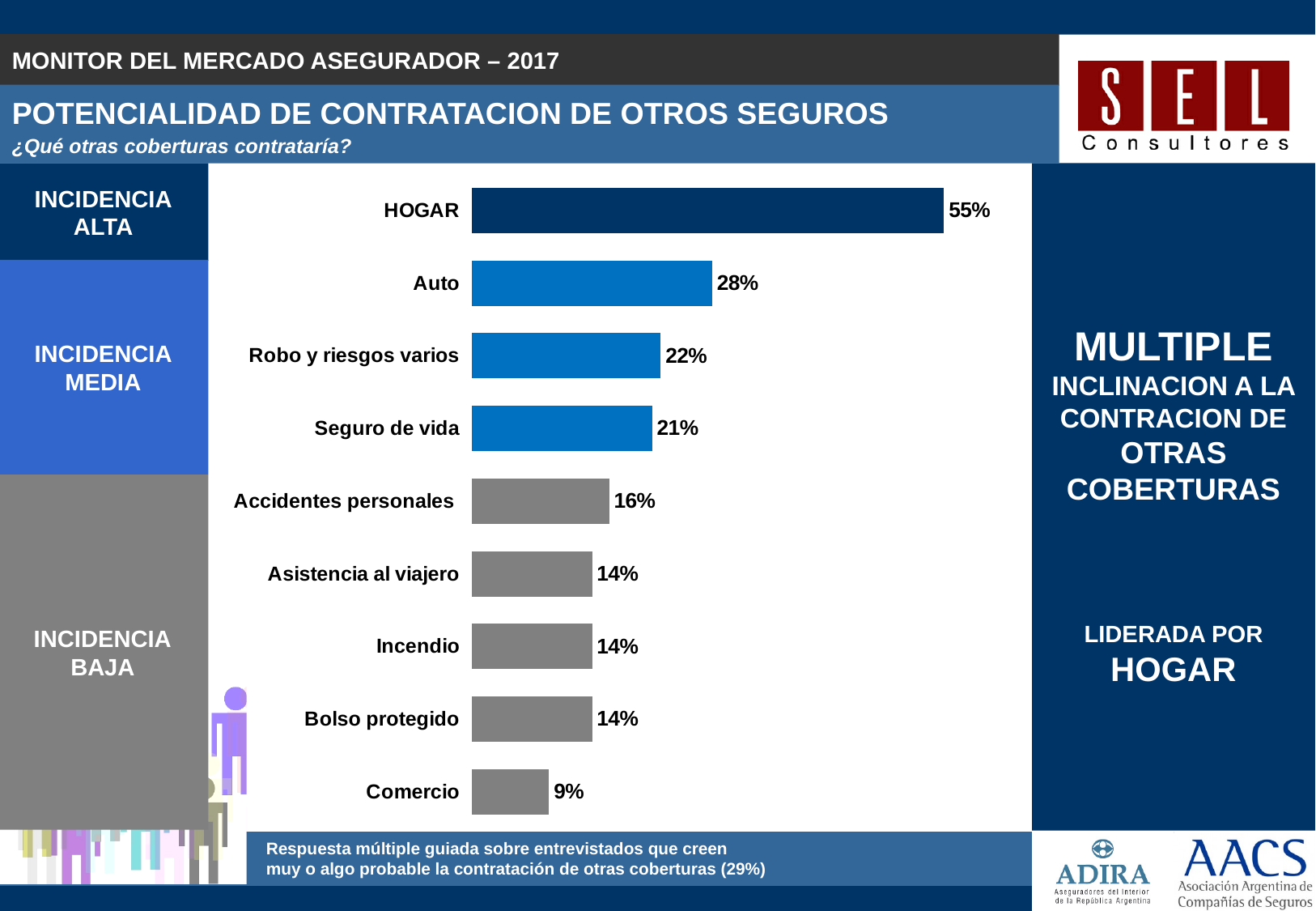
What kind of chart is shown on the slide? Bar chart What is the value for Seguro de vida? 21% Which category's bar is coloured dark navy, distinct from the others? HOGAR What is the difference between the values for HOGAR and Auto? 27% How many categories share the value 14%? 3 What is the difference between the values for Robo y riesgos varios and Accidentes personales? 6% Which is larger, the value for Auto or the value for Seguro de vida? Auto How many categories are plotted in the chart? 9 What percentage is shown for HOGAR? 55% Which category has the lowest value? Comercio Which category has the highest value? HOGAR What percentage is shown for Comercio? 9%